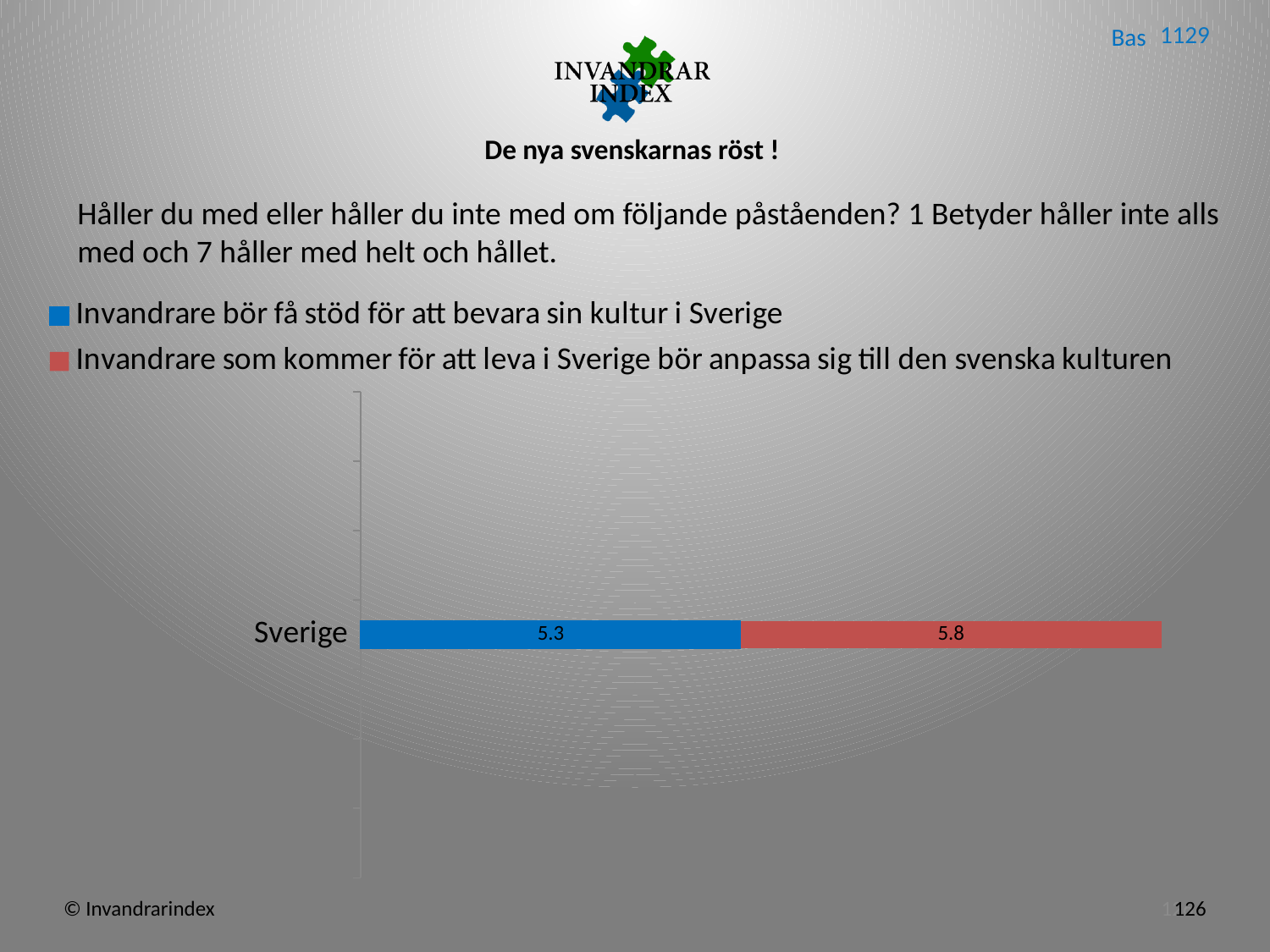
Which series has the higher value for Sverige: "Invandrare bör få stöd för att bevara sin kultur i Sverige" or "Invandrare som kommer för att leva i Sverige bör anpassa sig till den svenska kulturen"? Invandrare som kommer för att leva i Sverige bör anpassa sig till den svenska kulturen What kind of chart is shown on the slide? Bar chart What is the total of the stacked bar for Sverige? 11.1 What is the value for "Invandrare som kommer för att leva i Sverige bör anpassa sig till den svenska kulturen" for Sverige? 5.8 What is the name of the only category on the chart? Sverige Which colour represents "Invandrare bör få stöd för att bevara sin kultur i Sverige" in the legend? Blue How many categories are shown on the chart? 1 Which series has the lowest value for Sverige? Invandrare bör få stöd för att bevara sin kultur i Sverige What is the value for "Invandrare bör få stöd för att bevara sin kultur i Sverige" for Sverige? 5.3 How many series does the legend list? 2 What is the difference between the two series values for Sverige? 0.5